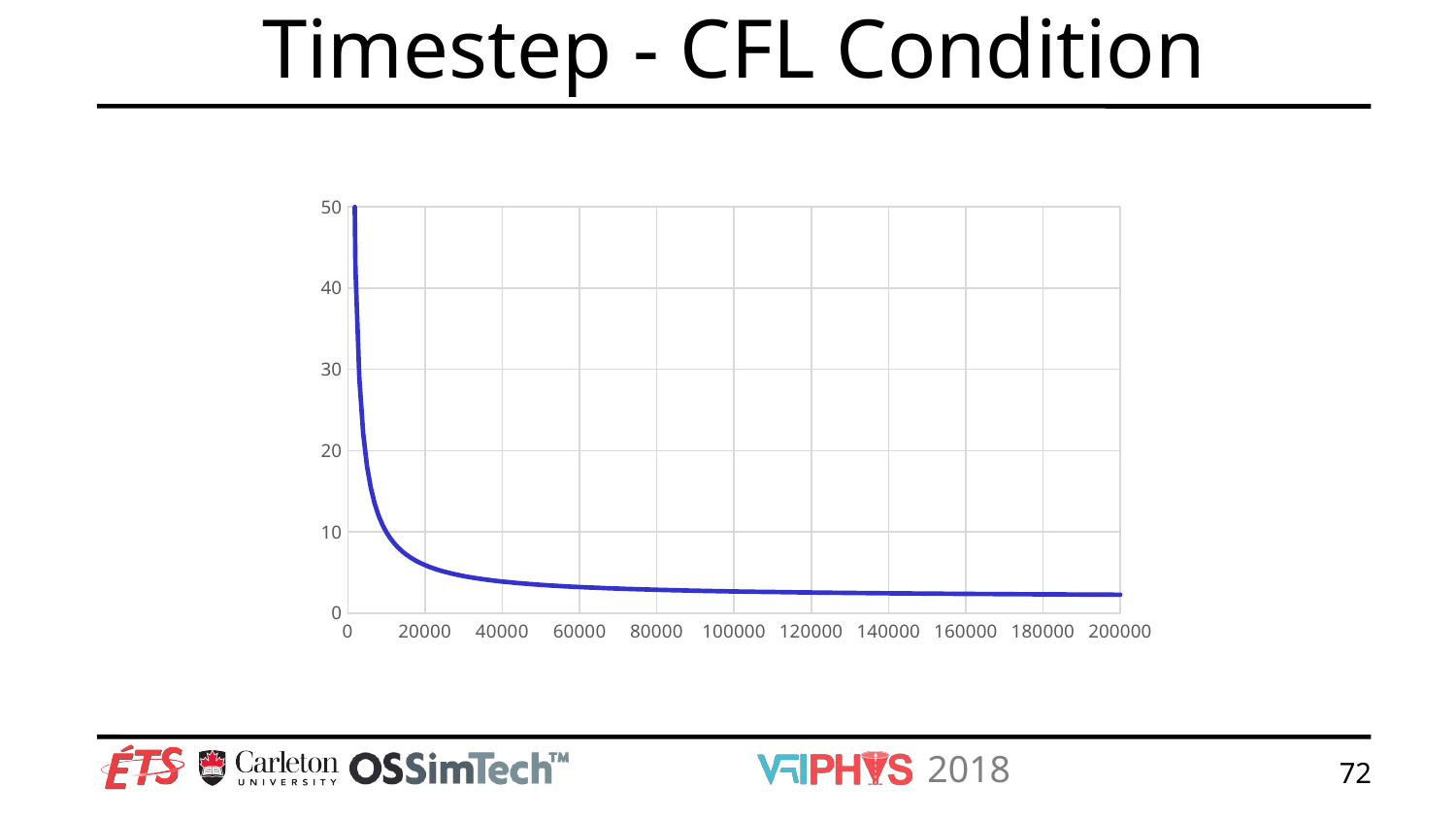
Is the value of the curve at x = 160000 greater or less than 20? less Is the value of the curve at x = 200000 greater or less than 10? less Is the value of the curve at x = 60000 greater or less than 30? less Does the plotted value rise or fall as the x axis increases? fall What kind of chart is shown on the slide? line chart What is the title of the slide containing the chart? Timestep - CFL Condition What is the highest tick value shown on the y axis? 50